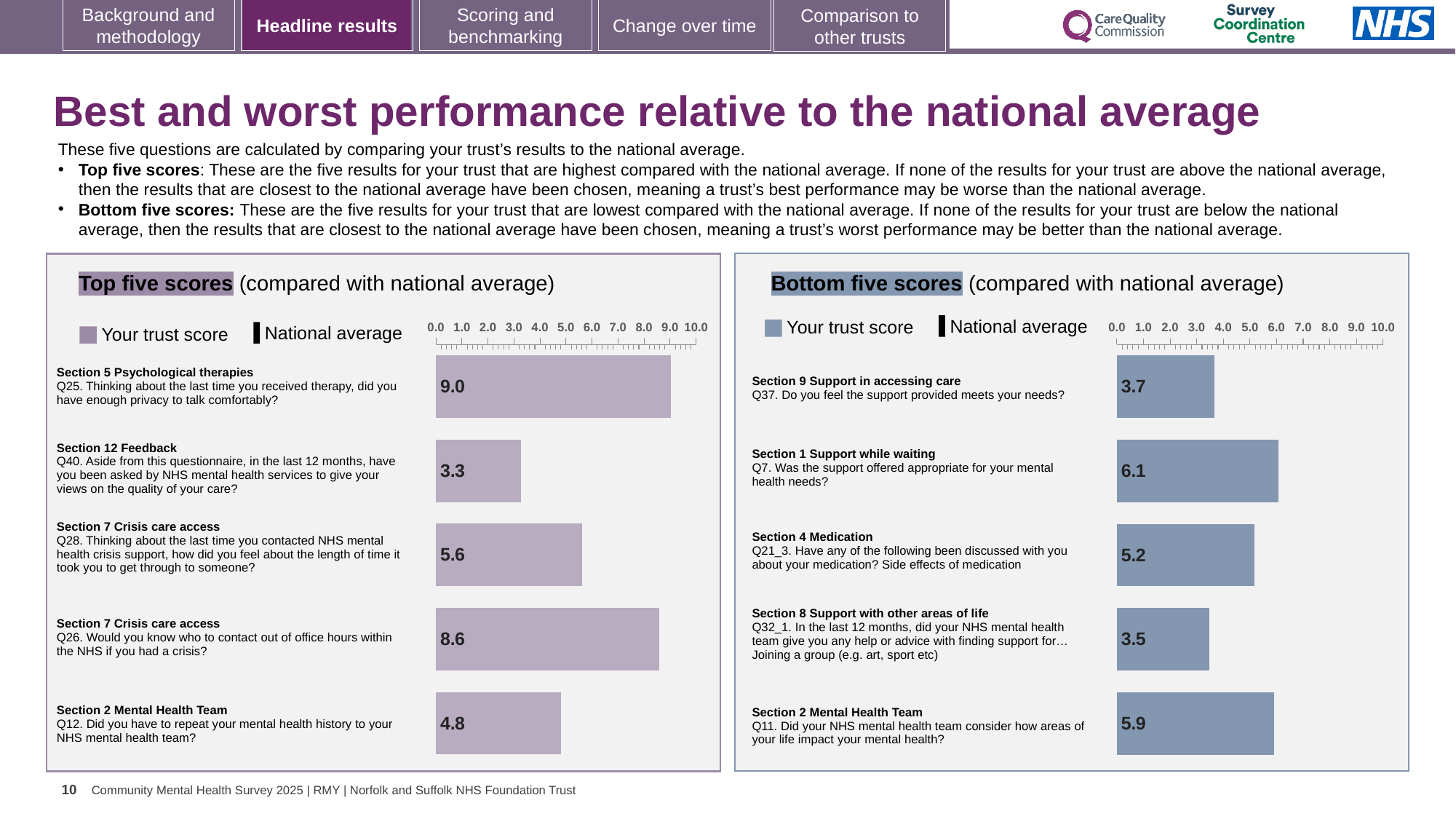
In the 'Bottom five scores' chart, what is the trust score for Q7 (Section 1 Support while waiting)? 6.1 In the 'Top five scores' chart, which question has the lowest trust score? Q40 In the 'Top five scores' chart, which question has the highest trust score? Q25 What type of chart is the 'Top five scores' chart? Bar chart In the 'Bottom five scores' chart, is the trust score for Q21_3 greater or less than 4.0? greater In the 'Top five scores' chart, which has the larger trust score, Q28 or Q26? Q26 In the 'Top five scores' chart, what is the difference between the trust scores for Q25 and Q40? 5.7 How many bars are plotted in the 'Bottom five scores' chart? 5 In the 'Bottom five scores' chart, what is the difference between the trust scores for Q7 and Q32_1? 2.6 How many series does the legend of the 'Top five scores' chart list? 2 In the 'Bottom five scores' chart, which question has the highest trust score? Q7 In the 'Top five scores' chart, what is the trust score for Q25 (Section 5 Psychological therapies)? 9.0